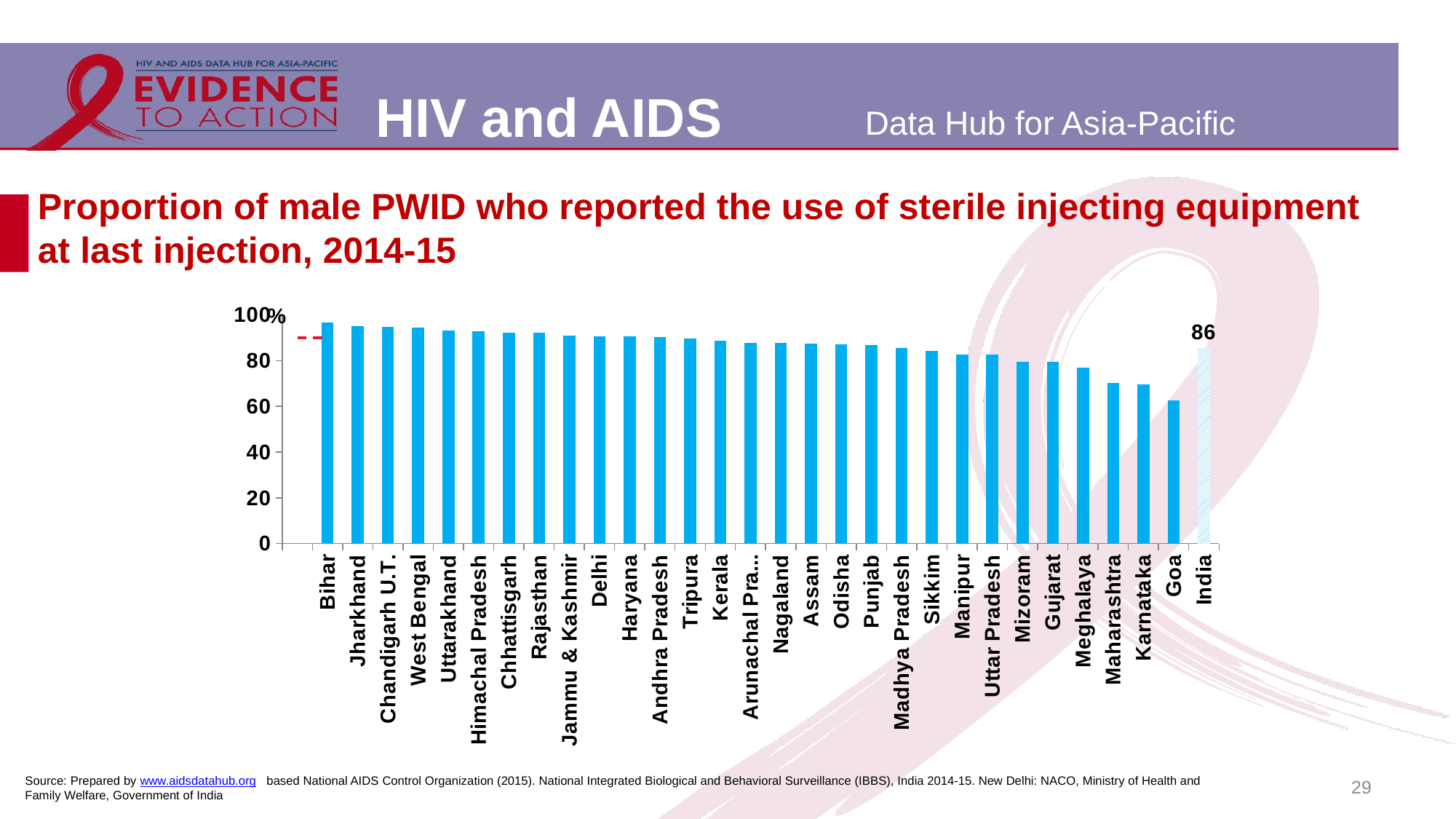
Do the bar values generally rise or fall from left to right across the states? Fall Which is larger, the value for Jharkhand or the value for Karnataka? Jharkhand Is the value for Maharashtra greater or less than 60? greater Is the value for Maharashtra greater or less than 80? less Which category has the highest bar? Bihar What kind of chart is shown on the slide? Bar chart Is the value for Goa greater or less than 80? less Which category has the lowest bar? Goa How many categories are plotted on the x axis? 30 Which is larger, the value for Goa or the value for India? India What is the value shown for India? 86